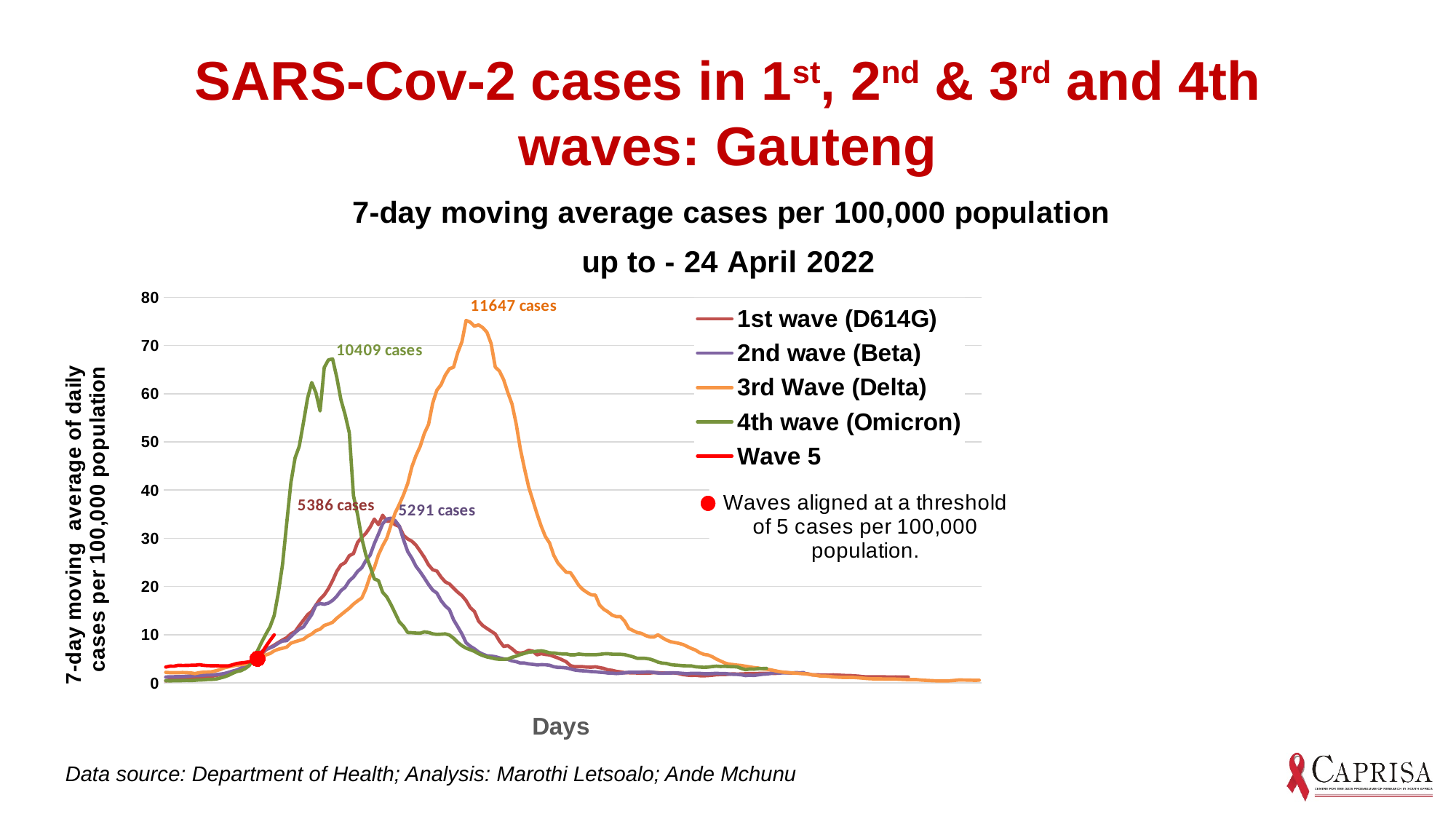
How many series does the chart legend list? 5 Which wave has a higher peak, the 4th wave (Omicron) or the 1st wave (D614G)? 4th wave (Omicron) How many cases are annotated at the peak of the 4th wave (Omicron)? 10409 cases How many cases are annotated at the peak of the 1st wave (D614G)? 5386 cases What type of chart is shown on the slide? Line chart At what threshold of cases per 100,000 population are the waves aligned in the chart? 5 cases per 100,000 population What is the difference between the annotated peak cases of the 3rd Wave (Delta) and the 4th wave (Omicron)? 1238 cases Which series in the chart reaches the lowest peak? Wave 5 How many cases are annotated at the peak of the 2nd wave (Beta)? 5291 cases Is the peak value of the 3rd Wave (Delta) greater or less than 70 cases per 100,000 population? greater Which wave reaches the highest peak in 7-day moving average cases per 100,000 population? 3rd Wave (Delta) How many cases are annotated at the peak of the 3rd Wave (Delta)? 11647 cases